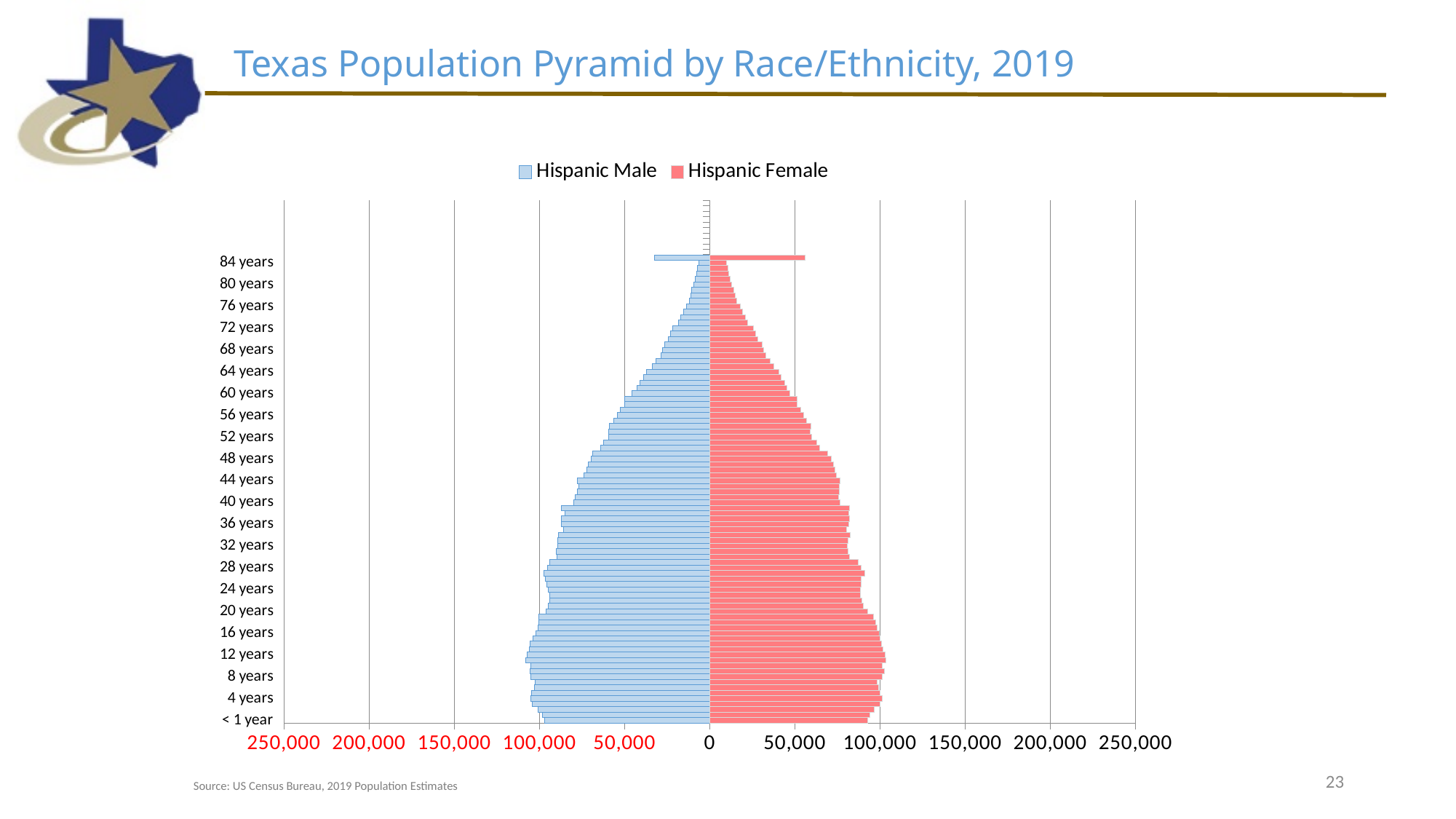
At 72 years, which is larger: the Hispanic Male value or the Hispanic Female value? Hispanic Female What are the two series named in the legend? Hispanic Male and Hispanic Female Is the Hispanic Male value for 76 years greater or less than 50,000? less Do the Hispanic Male bars generally get shorter or longer as age increases from 20 years to 80 years? shorter At 84 years, which is larger: the Hispanic Male value or the Hispanic Female value? Hispanic Female Is the Hispanic Male value for 84 years greater or less than 50,000? less How many series does the legend list? 2 What is the title of the slide's chart? Texas Population Pyramid by Race/Ethnicity, 2019 What kind of chart is shown on the slide? Bar chart Is the Hispanic Female value for 44 years greater or less than 100,000? less